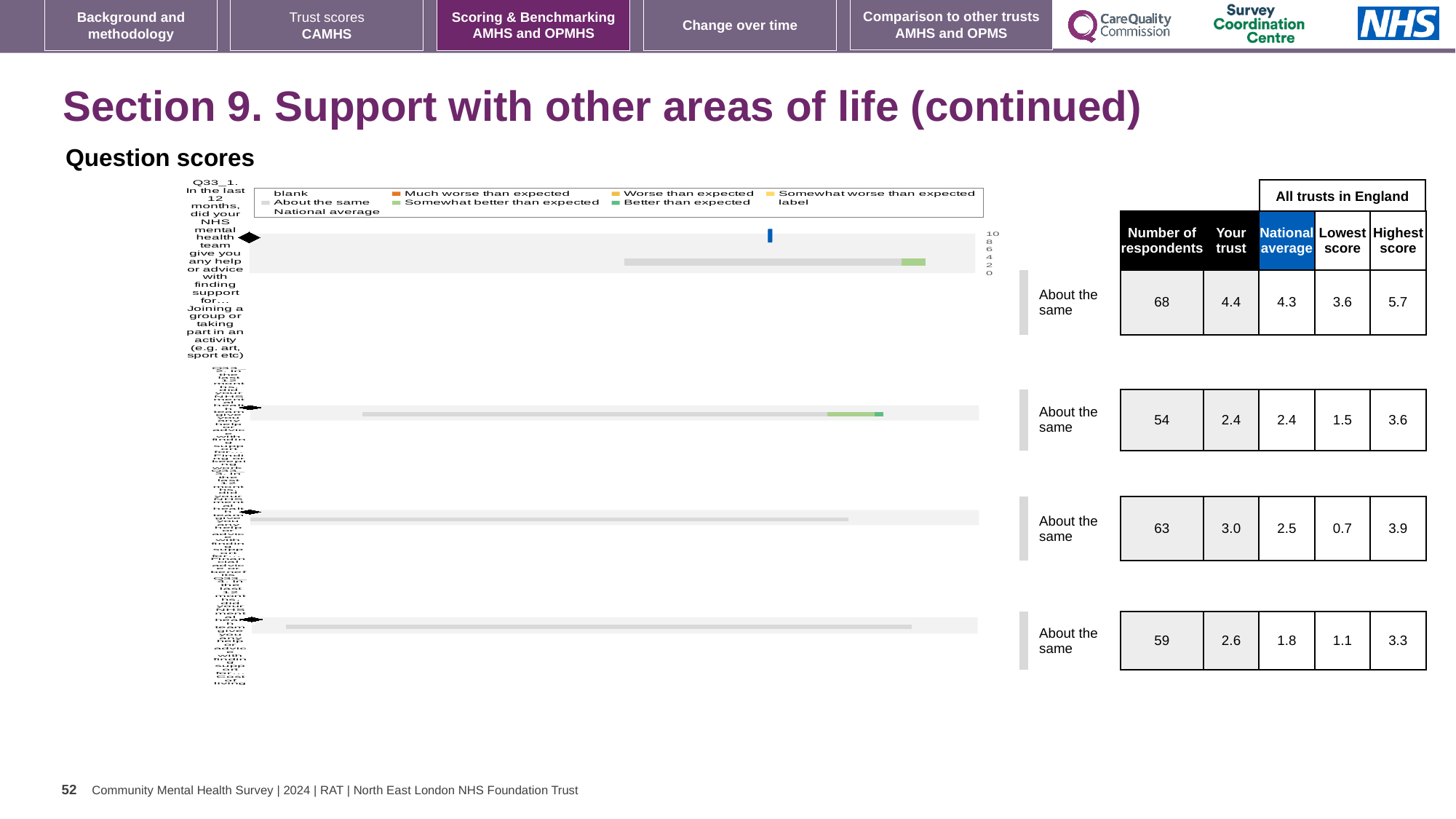
In the table beside the chart, what is the national average for the first row (Q33_1)? 4.3 In the table beside the chart, what is the 'Your trust' score for the first row (Q33_1)? 4.4 What is the question number of the first (top) category in the chart? Q33_1 What kind of chart is shown under 'Question scores'? bar chart For the first row (Q33_1), which is larger: the 'Your trust' score or the national average? Your trust For the first row (Q33_1), what is the difference between the highest score and the lowest score in the table? 2.1 Which row in the table has the highest 'Number of respondents'? the first row (Q33_1), 68 How many question rows (bars) are plotted in the chart? 4 How many entries does the chart's legend list? 9 In the table beside the chart, how many respondents are listed for the first row (Q33_1)? 68 What colour does the legend use for 'Much worse than expected'? orange What is the highest value shown on the chart's score axis? 10